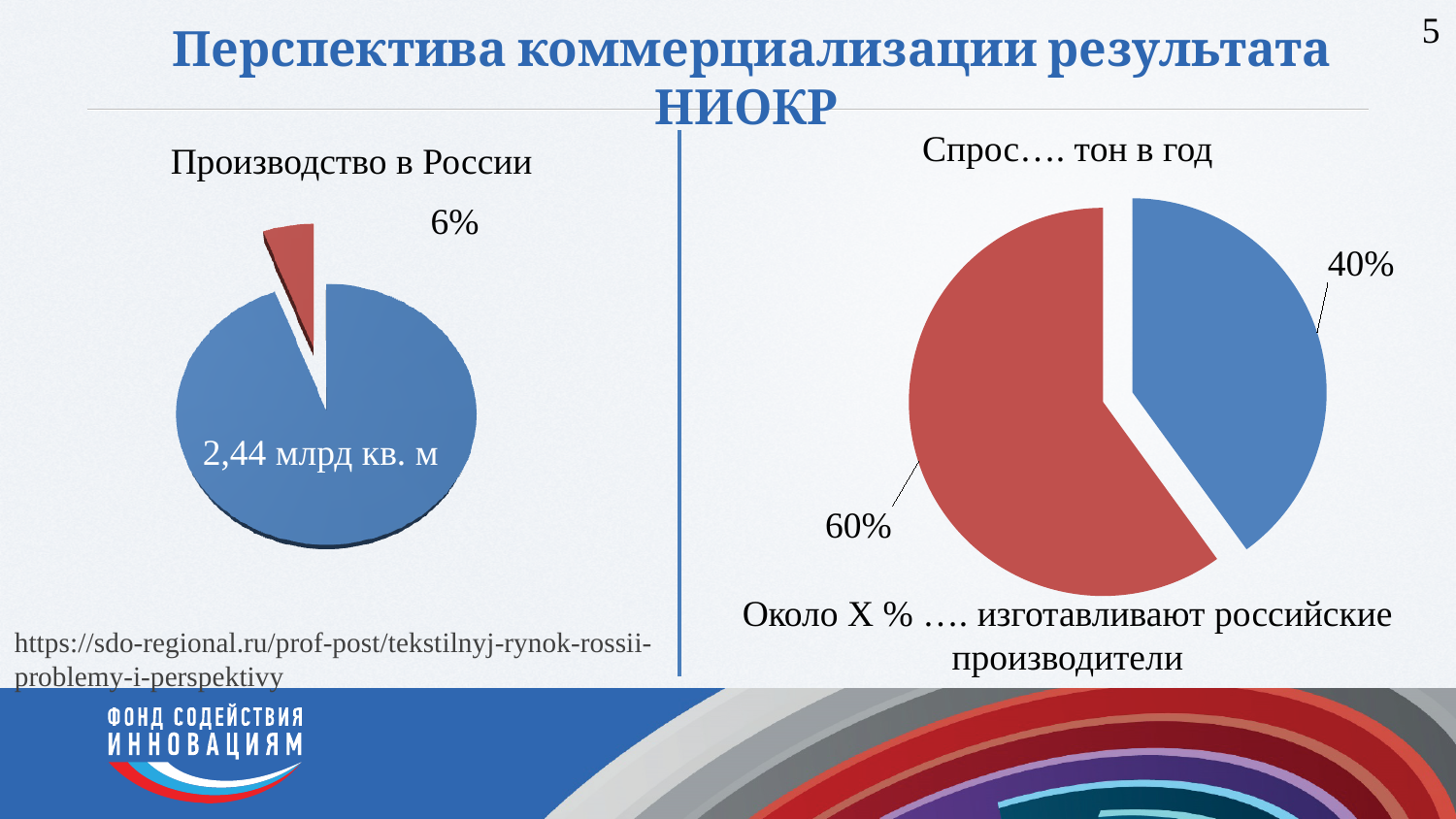
In the left chart "Производство в России", what value is printed on the large blue slice? 2,44 млрд кв. м How many slices does the right chart "Спрос…. тон в год" have? 2 How many pie charts are shown on the slide? 2 What kind of chart is the left chart titled "Производство в России"? pie chart In the right chart "Спрос…. тон в год", what share does the red slice have? 60% In the right chart "Спрос…. тон в год", what is the difference between the red slice's share and the blue slice's share? 20% In the right chart "Спрос…. тон в год", what share does the blue slice have? 40% In the right chart "Спрос…. тон в год", which slice is larger, the blue one or the red one? the red one In the left chart "Производство в России", what percentage is printed next to the small red slice? 6% What kind of chart is the right chart titled "Спрос…. тон в год"? pie chart In the left chart "Производство в России", which slice is larger, the blue one or the red one? the blue one How many slices does the left chart "Производство в России" have? 2